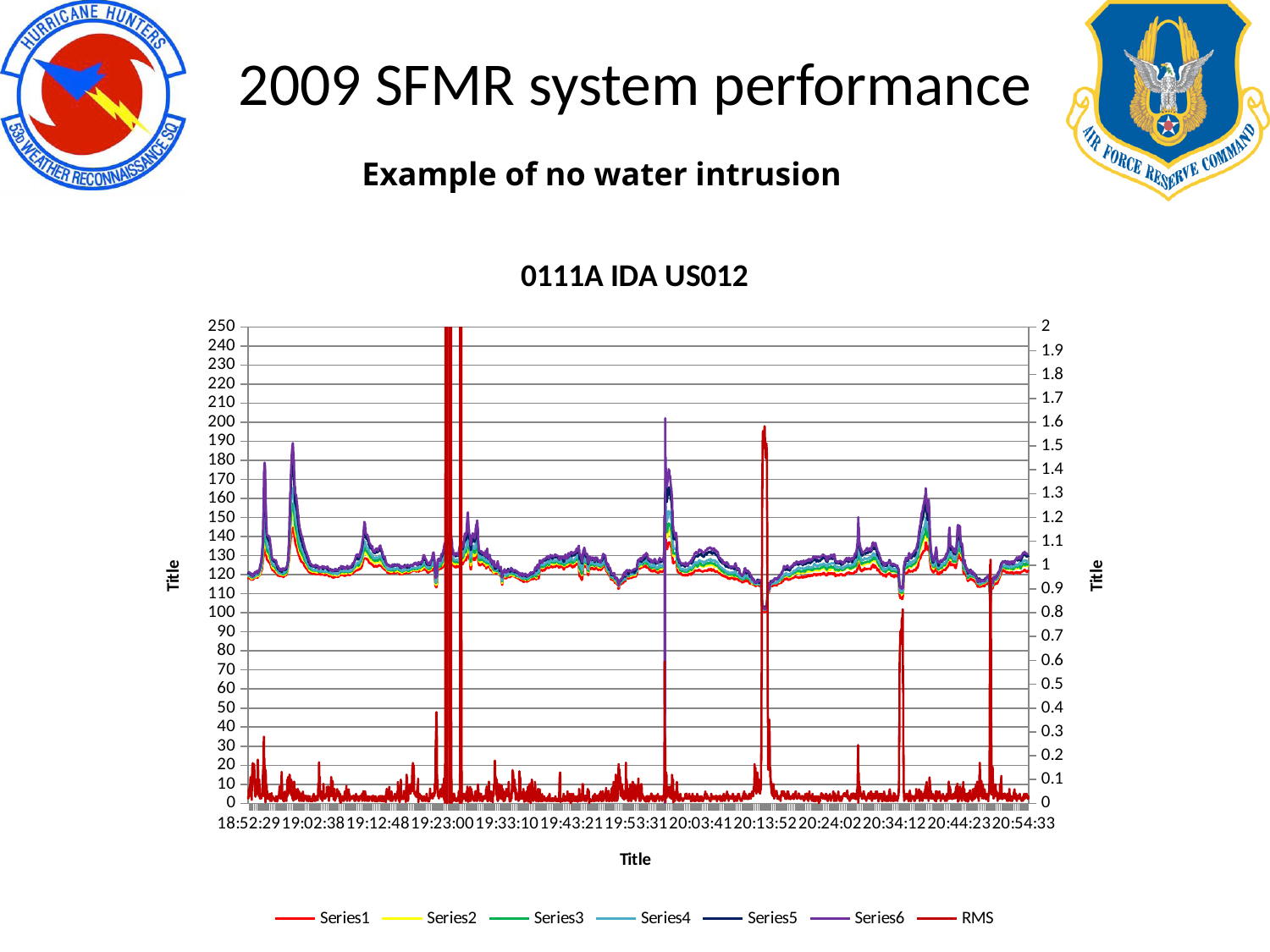
What is the title of the chart? 0111A IDA US012 Is the value of Series1 around 19:33:10 greater or less than 130 on the left axis? less What is the name of the last series listed in the legend? RMS At 19:02:38, which is higher, Series6 or Series1? Series6 How many series does the legend list? 7 Is the value of Series6 around 20:13:52 greater or less than 150 on the left axis? less Is the peak value of Series6 near 19:02:38 greater or less than 170 on the left axis? greater What kind of chart is shown on the slide? line chart